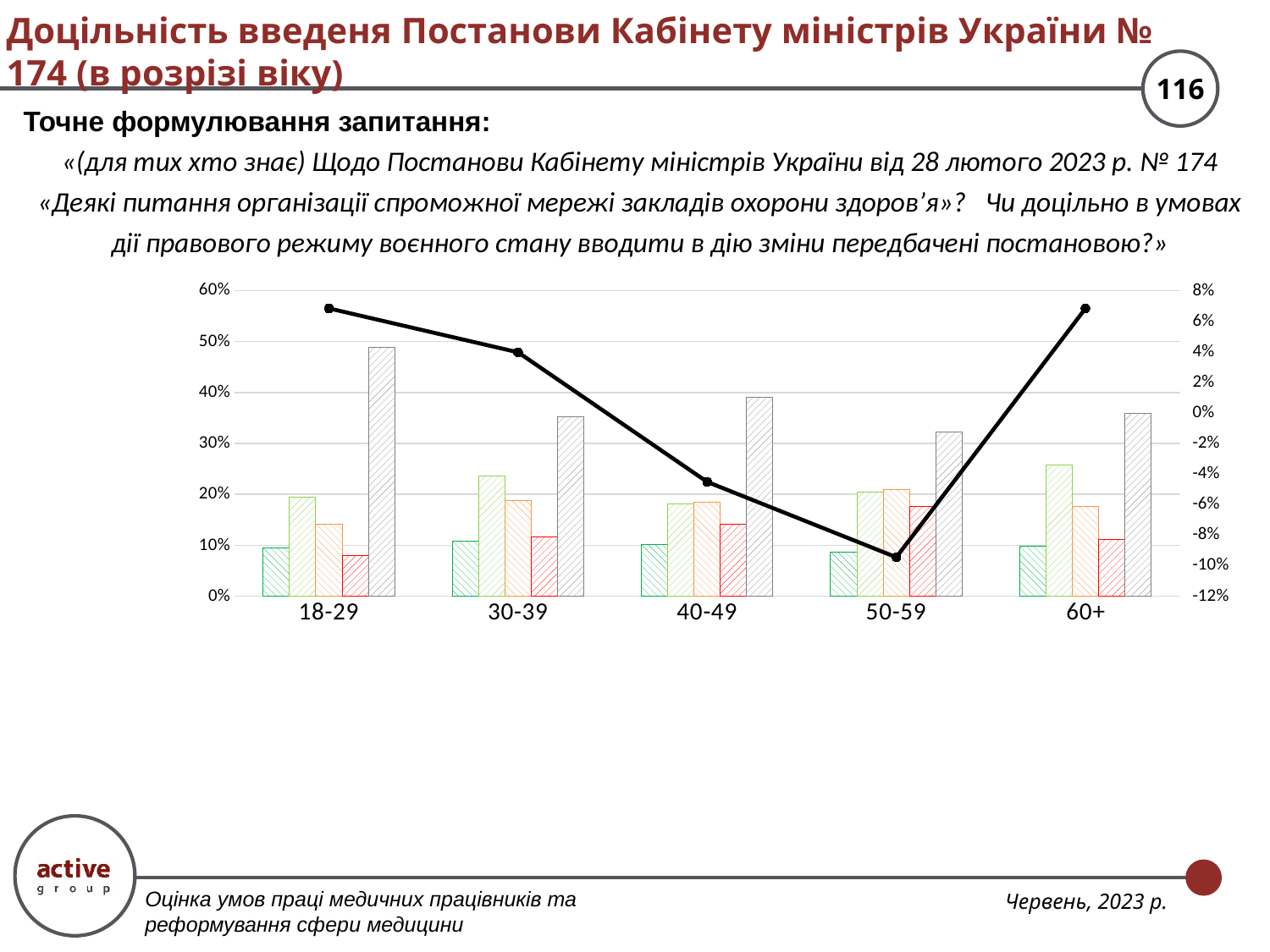
Which age group has the lowest value on the black line? 50-59 Is the black line value for the 50-59 group greater or less than 0%? less Is the black line value for the 18-29 group greater or less than 4%? greater How does the black line change from the 18-29 group to the 50-59 group? It falls How many age groups are shown on the x axis of the chart? 5 How many bars are plotted for each age group? 5 Is the black line value for the 40-49 group greater or less than 0%? less What kind of chart is shown on the slide? A combined bar and line chart On the black line, which is larger: the value for 30-39 or the value for 40-49? 30-39 What is the highest tick value shown on the left vertical axis? 60%